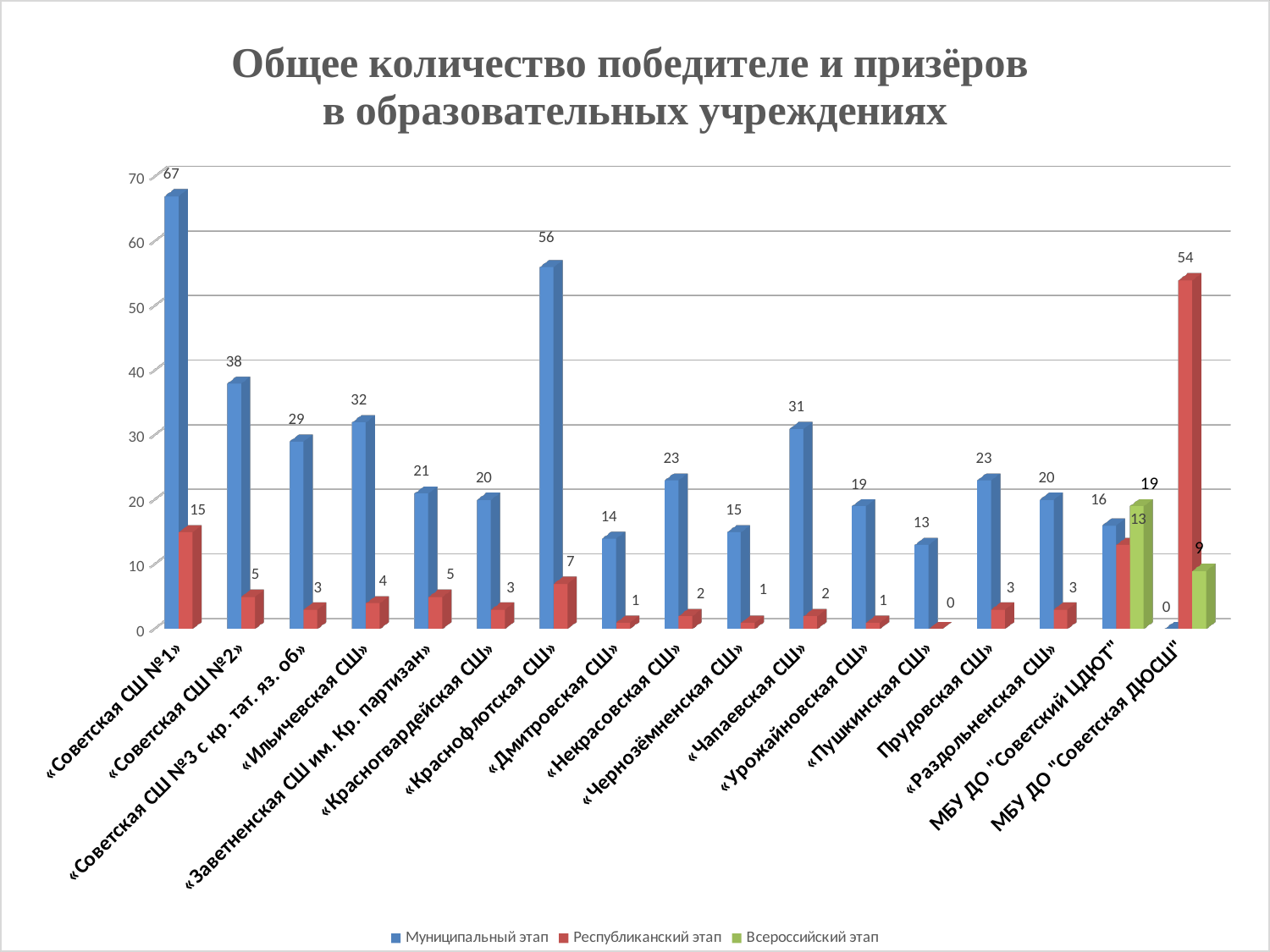
What is the value of Республиканский этап for МБУ ДО "Советская ДЮСШ"? 54 What is the value of Всероссийский этап for МБУ ДО "Советский ЦДЮТ"? 19 Which category has the lowest value for Муниципальный этап? МБУ ДО "Советская ДЮСШ" Which category has the highest value for Муниципальный этап? «Советская СШ №1» What type of chart is shown on the slide? Bar chart How many series does the legend list? 3 How many categories (institutions) are shown on the x axis? 17 Which is larger: the Муниципальный этап value for «Ильичевская СШ» or for «Чапаевская СШ»? «Ильичевская СШ» Which series is shown in green in the legend? Всероссийский этап What is the total of the three series values for МБУ ДО "Советский ЦДЮТ"? 48 What is the value of Муниципальный этап for «Советская СШ №1»? 67 What is the difference between the Муниципальный этап values for «Советская СШ №1» and «Краснофлотская СШ»? 11